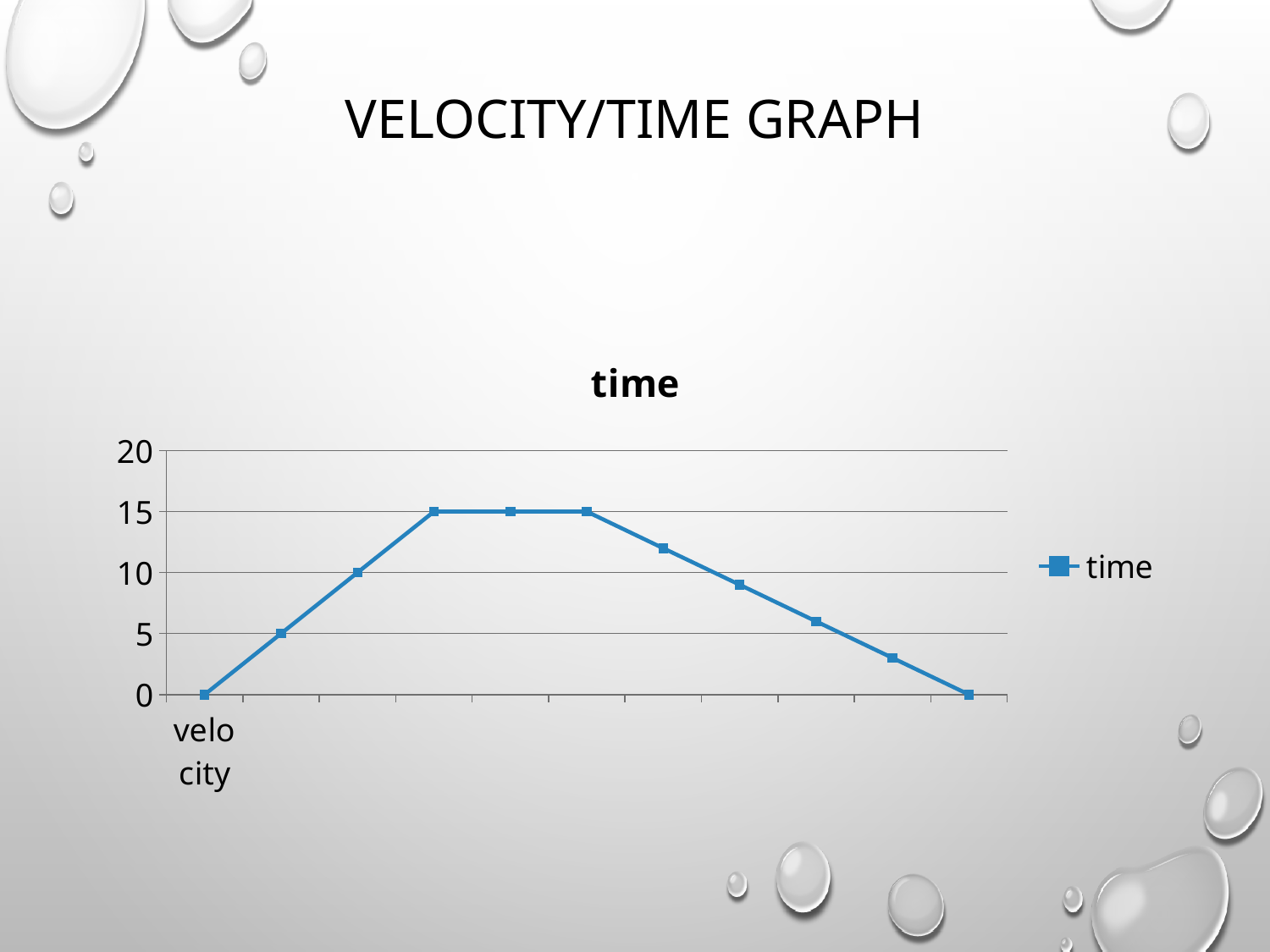
How many data points are plotted on the line? 11 What is the value of the first data point, labelled 'velocity'? 0 Which is larger, the second data point or the third data point? the third data point How many series does the legend list? 1 What is the value of the second data point on the line? 5 What is the title of the chart? time What kind of chart is shown on the slide? line chart What is the value of the third data point on the line? 10 Is the value of the seventh data point greater or less than 10? greater What is the lowest value on the line? 0 What is the highest value reached by the line? 15 Is the value of the tenth data point greater or less than 5? less